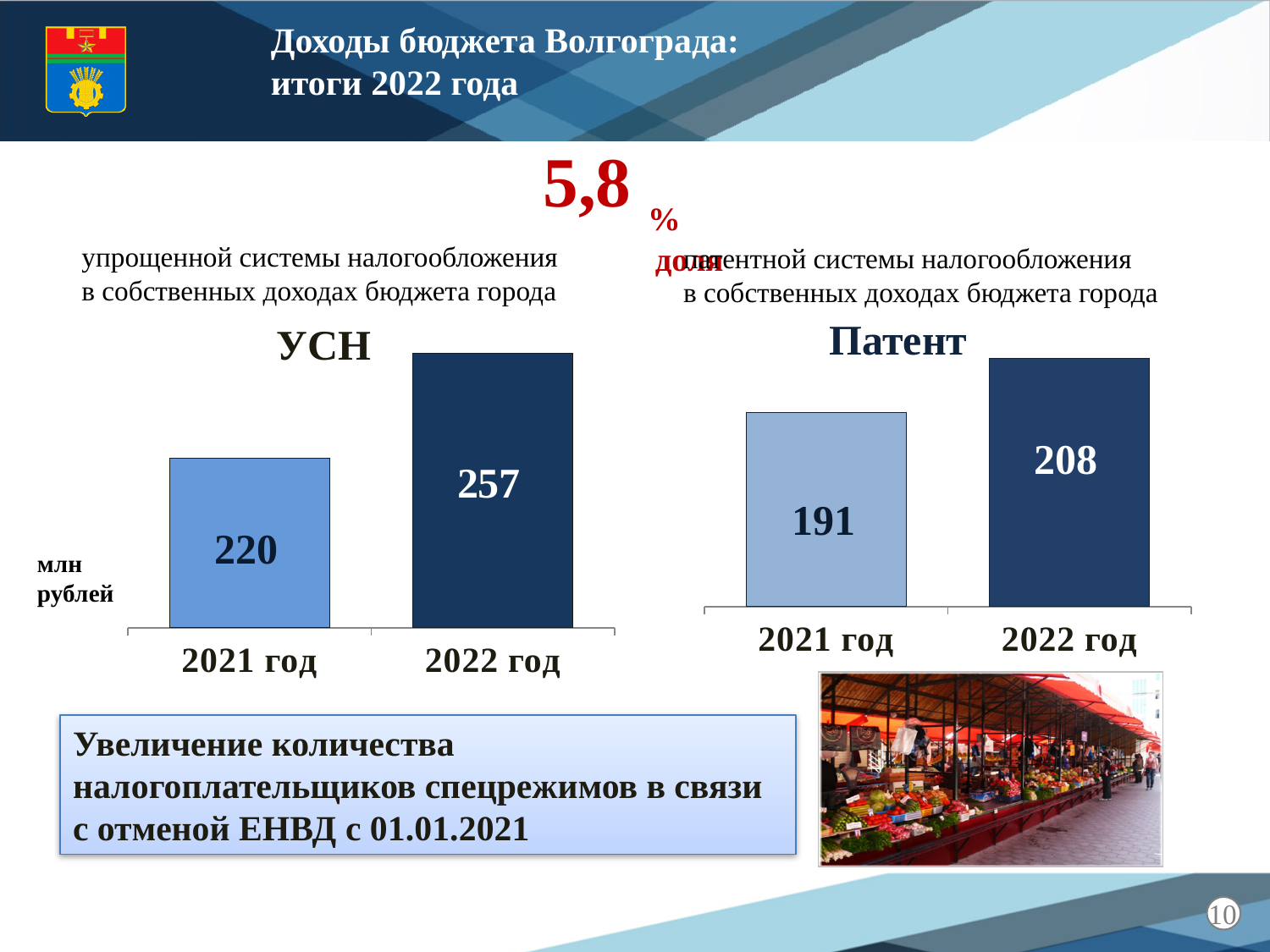
In the Патент chart, do the values rise or fall from 2021 год to 2022 год? rise In the Патент chart, what is the value for 2022 год? 208 In the Патент chart, what is the difference between the 2022 год and 2021 год values? 17 Which is larger: the 2022 год value in the УСН chart or the 2022 год value in the Патент chart? УСН 2022 год In the УСН chart, what is the value for 2021 год? 220 In the УСН chart, what is the difference between the 2022 год and 2021 год values? 37 In the Патент chart, what is the value for 2021 год? 191 In the УСН chart, what is the value for 2022 год? 257 In the Патент chart, which year has the lower value? 2021 год What kind of chart is the УСН chart? bar chart How many categories does the Патент chart show? 2 In the УСН chart, which year has the higher value? 2022 год